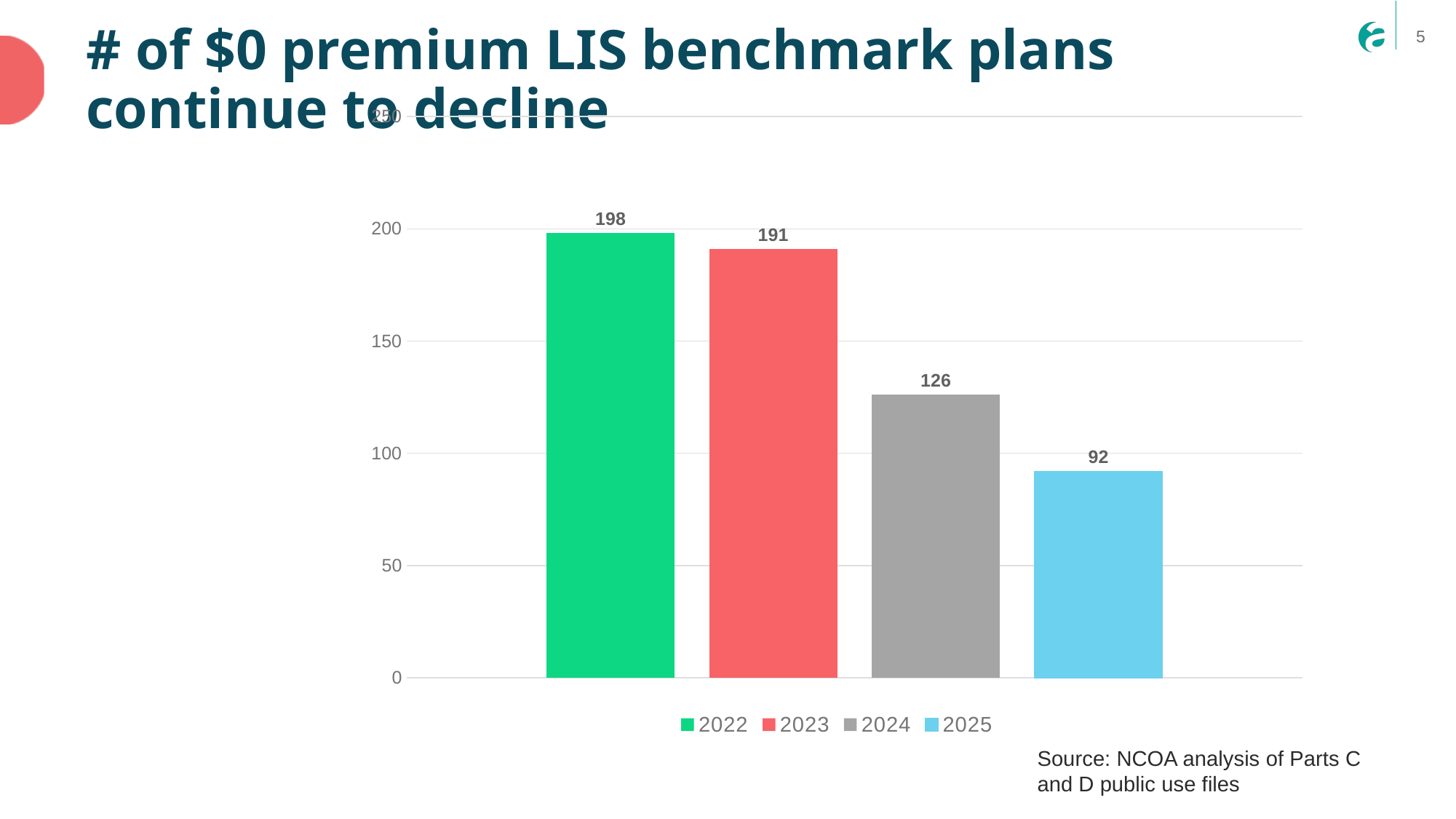
What is the difference between the 2022 and 2025 values? 106 Do the values rise or fall from 2022 to 2025? fall What value is shown for 2024? 126 Which year has the lowest number of $0 premium LIS benchmark plans? 2025 How many years are shown in the chart? 4 What is the number of $0 premium LIS benchmark plans for 2025? 92 Which is larger, the value for 2023 or the value for 2024? 2023 Which year has the highest number of $0 premium LIS benchmark plans? 2022 Is the value for 2025 greater or less than 100? less What is the difference between the 2023 and 2024 values? 65 What is the number of $0 premium LIS benchmark plans for 2022? 198 What kind of chart is shown on the slide? bar chart